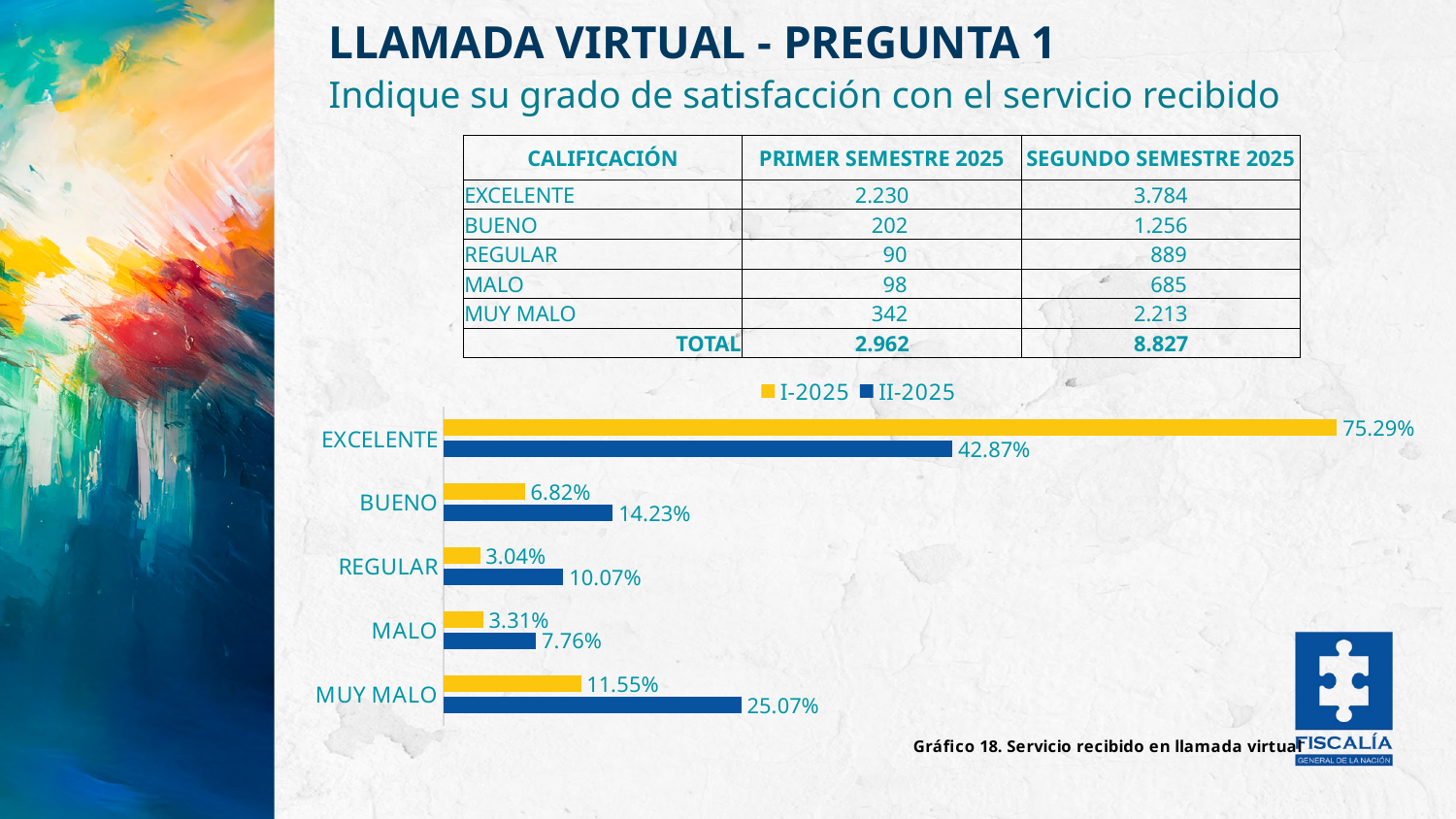
What is the value for EXCELENTE in the I-2025 series? 75.29% How many categories are shown on the chart? 5 Which category has the highest value in the II-2025 series? EXCELENTE What is the value for MALO in the I-2025 series? 3.31% What is the value for MUY MALO in the II-2025 series? 25.07% Which category has the lowest value in the I-2025 series? REGULAR What kind of chart is shown on the slide? Bar chart How many series does the chart legend list? 2 What is the difference between the II-2025 and I-2025 values for MUY MALO? 13.52% Which is larger for BUENO: the I-2025 value or the II-2025 value? II-2025 What is the value for REGULAR in the II-2025 series? 10.07% What is the difference between the I-2025 and II-2025 values for EXCELENTE? 32.42%